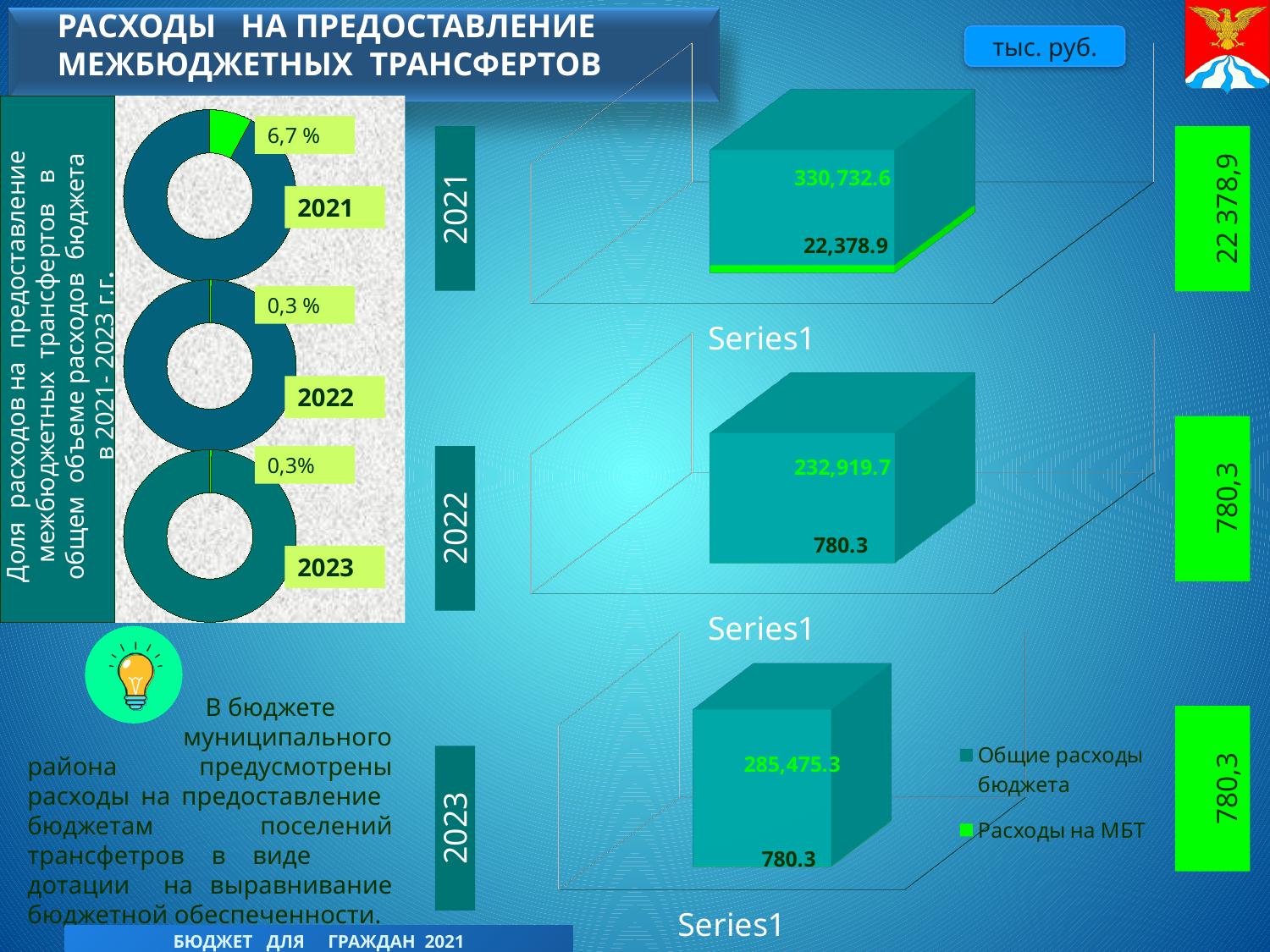
In the 2023 bar chart, what is the value for Общие расходы бюджета? 285,475.3 In the 2021 bar chart, what is the value for Общие расходы бюджета? 330,732.6 Which year's bar chart shows the highest value for Общие расходы бюджета: 2021, 2022 or 2023? 2021 In the 2021 bar chart, what is the value for Расходы на МБТ? 22,378.9 In the 2022 bar chart, what is the value for Расходы на МБТ? 780.3 In the 2022 donut chart, what share of total budget expenses do the intergovernmental transfers (МБТ) make up? 0,3 % How many series does the legend of the bar charts list? 2 In the 2022 bar chart, what is the value for Общие расходы бюджета? 232,919.7 Which year's bar chart shows the lowest value for Общие расходы бюджета: 2021, 2022 or 2023? 2022 In the 2023 bar chart, what is the value for Расходы на МБТ? 780.3 In the 2021 donut chart, what share of total budget expenses do the intergovernmental transfers (МБТ) make up? 6,7 % What kind of chart is used for the 2021, 2022 and 2023 charts on the right side of the slide? Bar chart